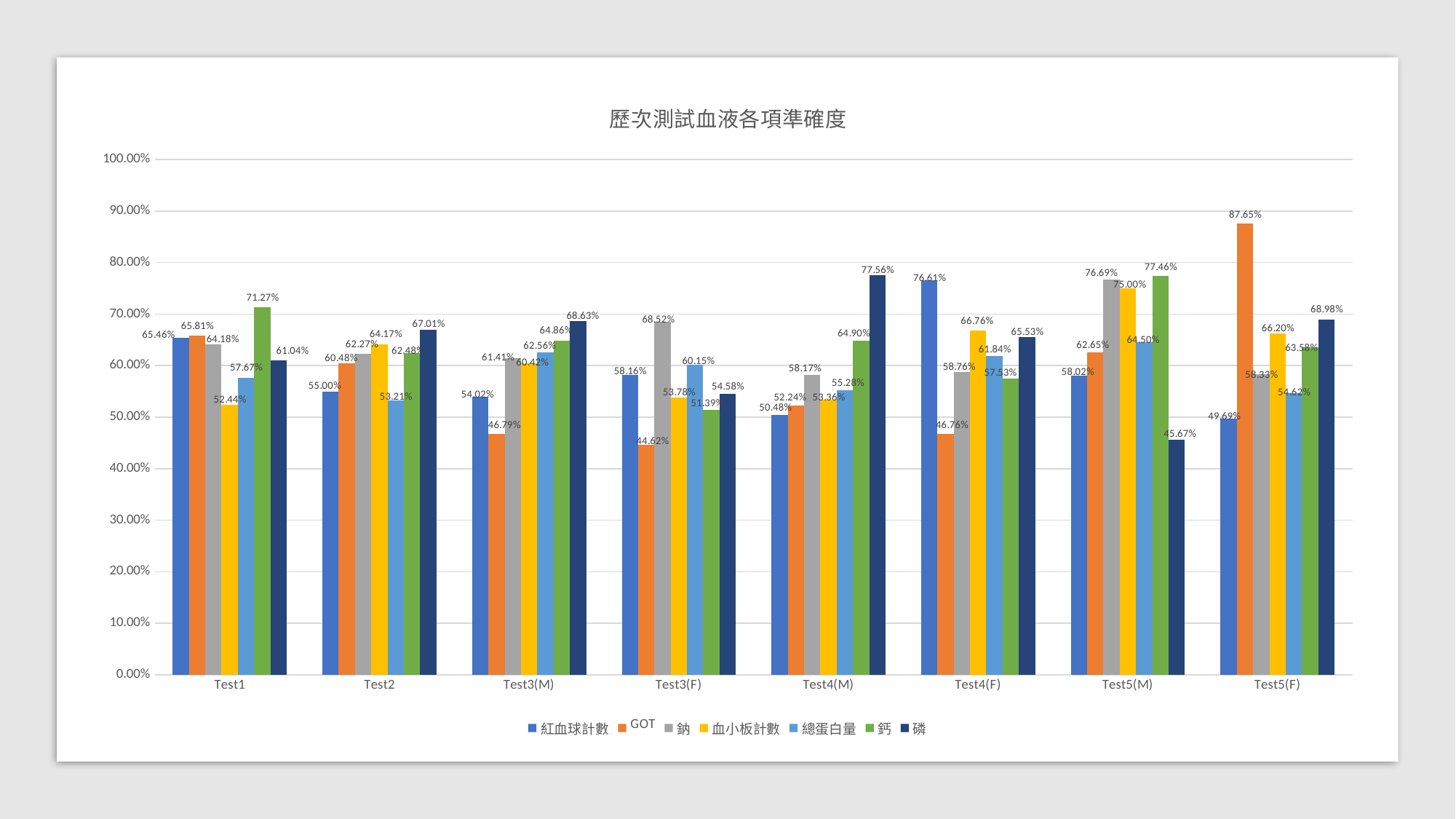
What is the difference between 鈣 and 磷 for Test5(M)? 31.79% What is the difference between 鈣 and 血小板計數 for Test1? 18.83% What is the value of 磷 for Test4(M)? 77.56% For Test4(F), which is larger: 紅血球計數 or 血小板計數? 紅血球計數 Which series has the highest value in the Test5(F) group? GOT What is the value of GOT for Test5(F)? 87.65% Which series has the lowest value in the Test3(F) group? GOT How many test categories are shown on the x axis? 8 Is the value of 磷 for Test5(M) greater or less than 50%? less What is the value of 鈣 for Test1? 71.27% What type of chart is shown on the slide? bar chart How many series does the legend list? 7